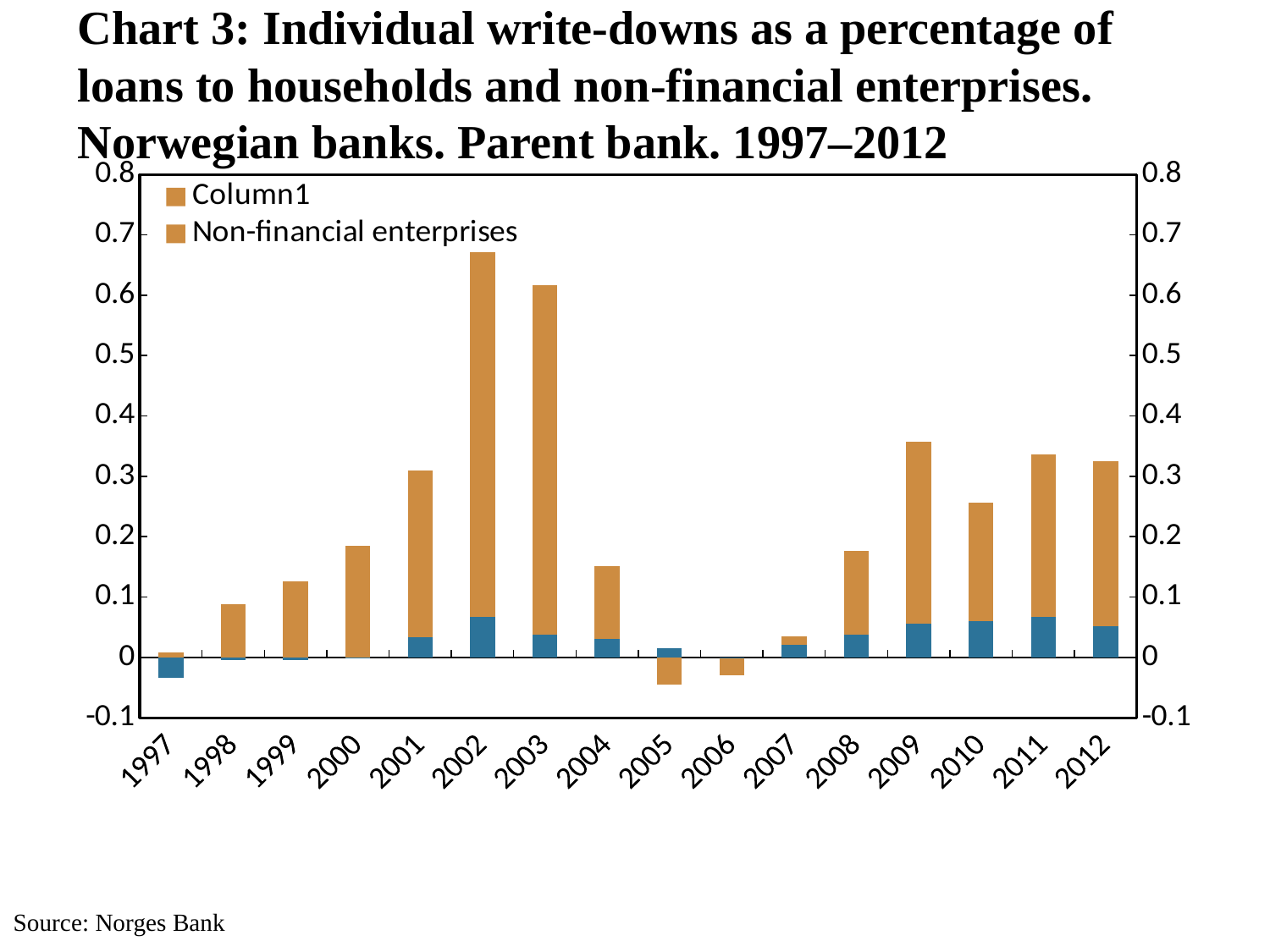
What is the second entry listed in the chart's legend? Non-financial enterprises Which year has the tallest bar in the chart? 2002 Which year has the taller bar, 2009 or 2010? 2009 What kind of chart is shown on the slide? bar chart Do the bar heights rise or fall from 1997 to 2002? rise How many series does the chart's legend list? 2 How many years are shown on the x axis of the chart? 16 Is the value of the orange bar for 1998 greater or less than 0.1? less Is the value of the orange bar for 2009 greater or less than 0.3? greater Is the value of the orange bar for 2010 greater or less than 0.3? less